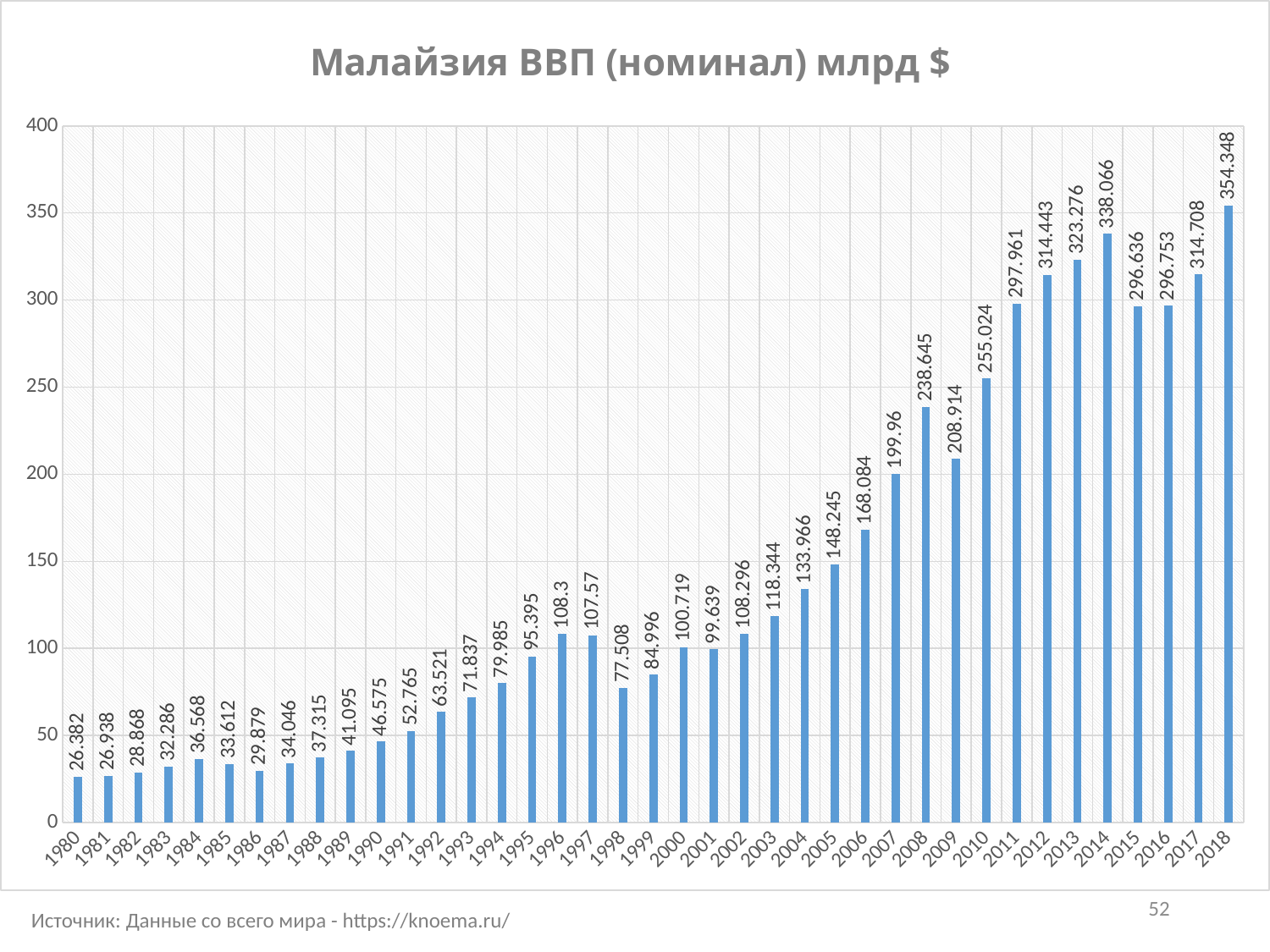
What type of chart is shown on the slide? Bar chart Which year has the lowest value? 1980 What is the value for 2007? 199.96 What is the title of the chart? Малайзия ВВП (номинал) млрд $ What is the difference between the values for 2018 and 2017? 39.64 Is the value for 2010 greater or less than 250? greater What is the value for 1997? 107.57 What is the difference between the values for 2014 and 2015? 41.43 What is the value for 2018? 354.348 How many years are shown on the x axis? 39 Which is larger, the value for 1997 or the value for 1998? 1997 Which year has the highest value? 2018